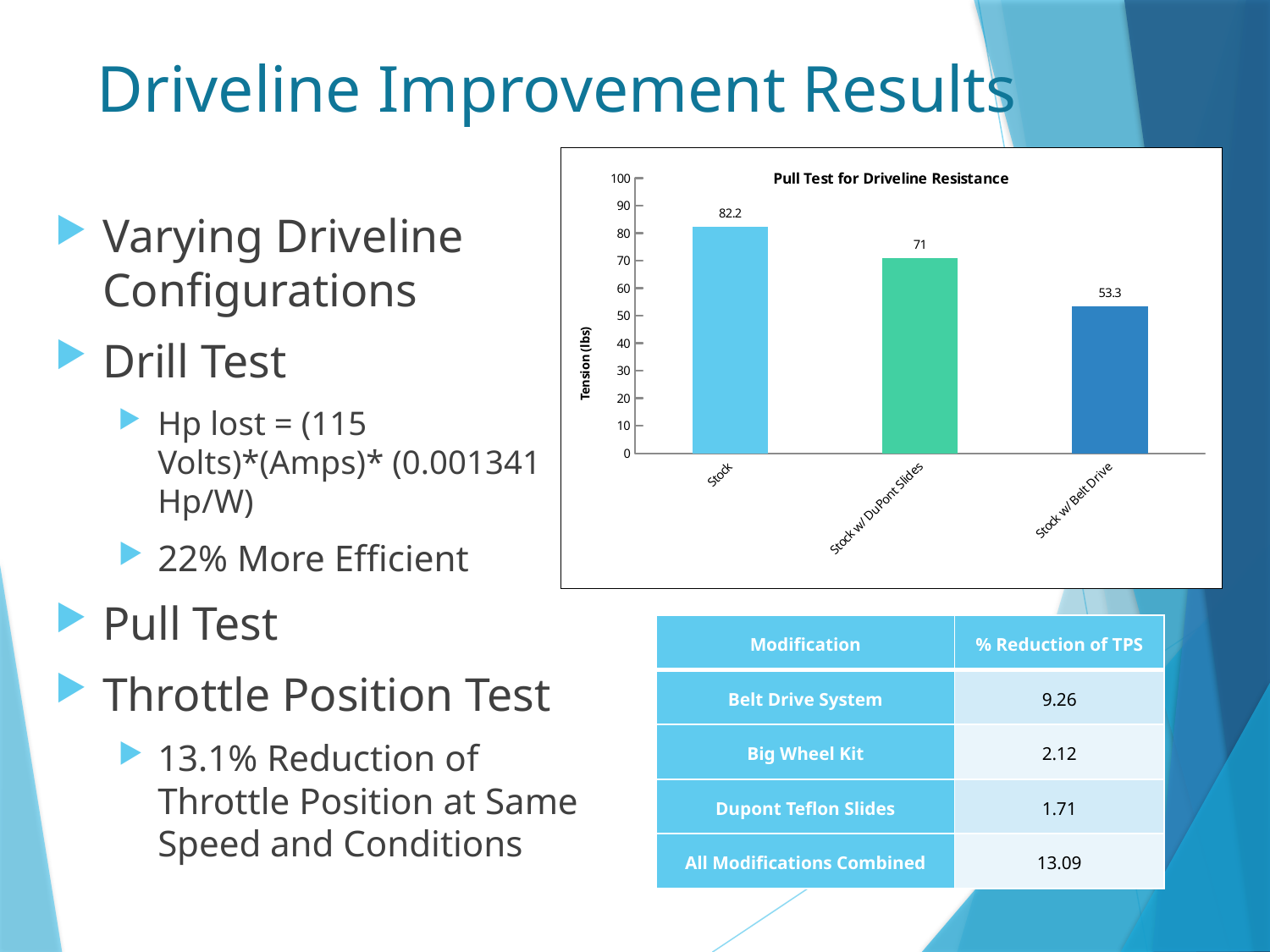
What kind of chart is the Pull Test for Driveline Resistance chart? Bar chart What is the difference in tension between Stock and Stock w/ DuPont Slides? 11.2 How many driveline configurations are plotted in the chart? 3 What is the difference in tension between Stock and Stock w/ Belt Drive? 28.9 What is the tension value for Stock w/ DuPont Slides? 71 What is the label of the y-axis in the chart? Tension (lbs) Which configuration has the lowest tension in the chart? Stock w/ Belt Drive What is the tension value for Stock w/ Belt Drive? 53.3 Which has a larger tension value, Stock w/ DuPont Slides or Stock w/ Belt Drive? Stock w/ DuPont Slides Do the tension values rise or fall from left to right across the chart? Fall Which configuration has the highest tension in the chart? Stock What is the tension value for Stock in the Pull Test for Driveline Resistance chart? 82.2